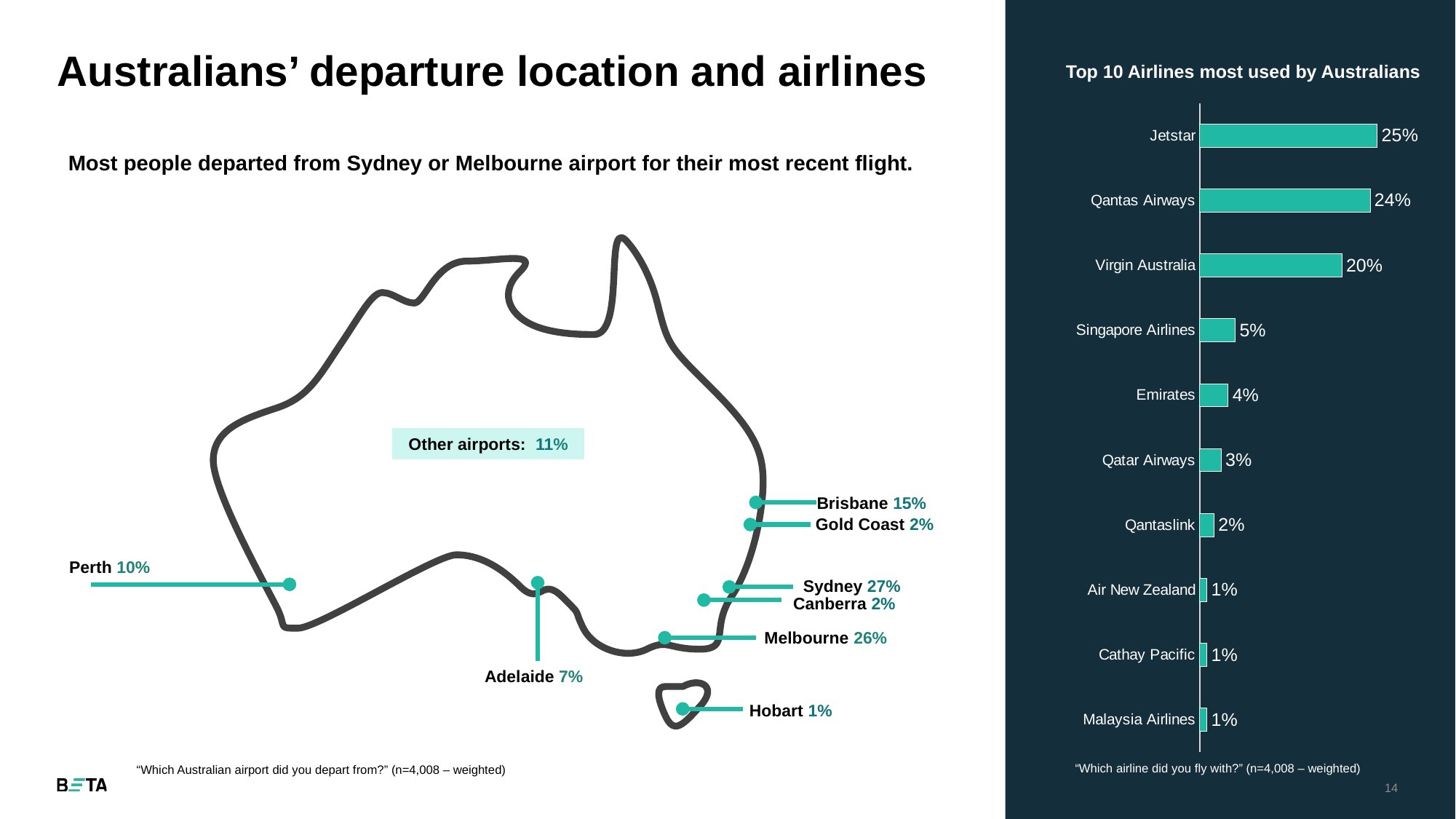
On the map of Australian departure airports, what percentage departed from Sydney? 27% In the 'Top 10 Airlines most used by Australians' chart, what is the value for Singapore Airlines? 5% In the 'Top 10 Airlines most used by Australians' chart, which airline has the highest value? Jetstar In the 'Top 10 Airlines most used by Australians' chart, what is the difference between Jetstar and Qantas Airways? 1% What kind of chart is 'Top 10 Airlines most used by Australians'? Bar chart In the 'Top 10 Airlines most used by Australians' chart, which is larger, Emirates or Qatar Airways? Emirates In the 'Top 10 Airlines most used by Australians' chart, what is the value for Virgin Australia? 20% In the 'Top 10 Airlines most used by Australians' chart, what is the difference between Virgin Australia and Singapore Airlines? 15% In the 'Top 10 Airlines most used by Australians' chart, do the values rise or fall from top to bottom? Fall On the map of Australian departure airports, what is the difference between Brisbane and Perth? 5% How many airlines are shown in the 'Top 10 Airlines most used by Australians' chart? 10 What colour are the bars in the 'Top 10 Airlines most used by Australians' chart? Teal/green